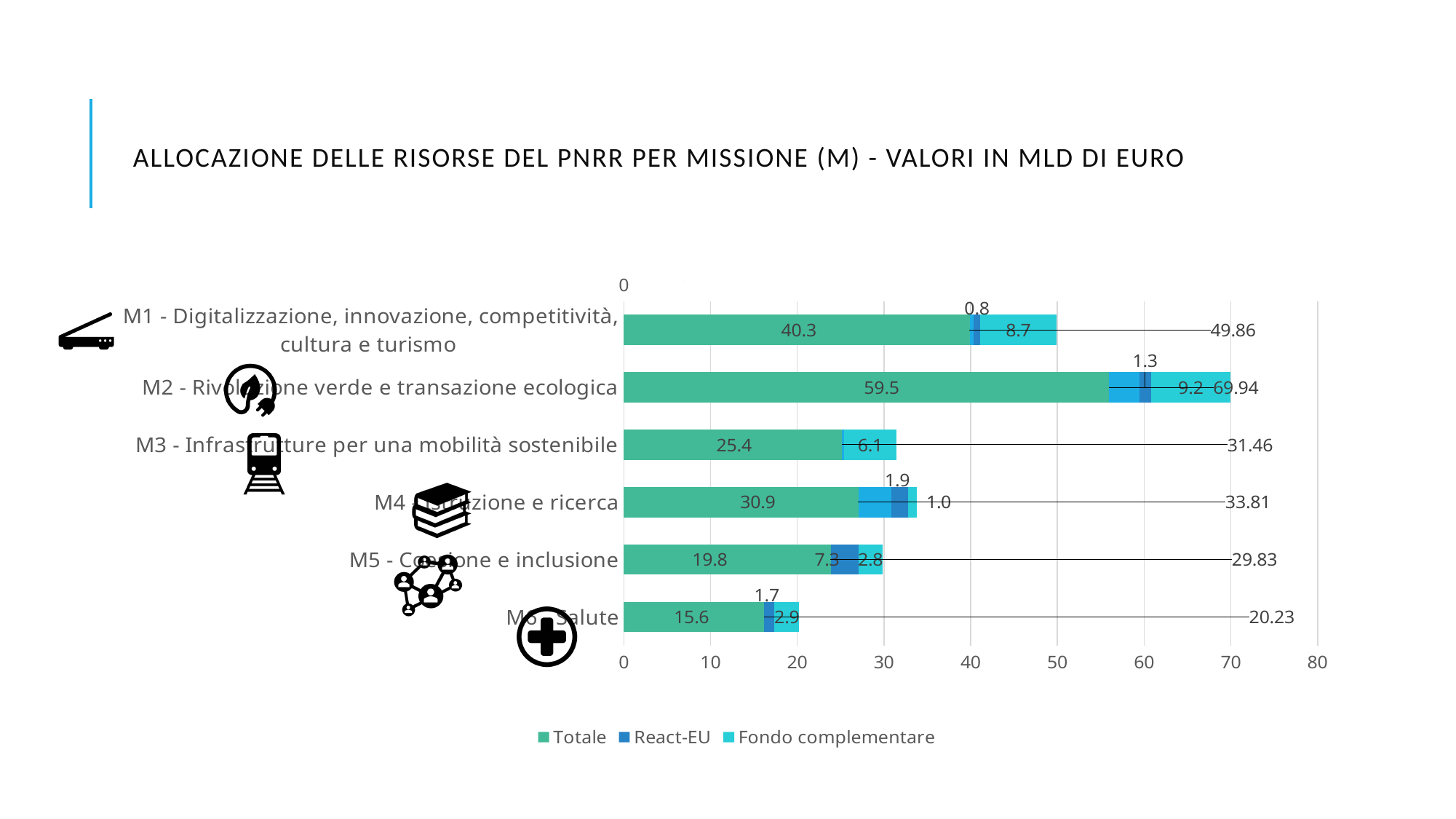
What is the Fondo complementare value for M1 - Digitalizzazione, innovazione, competitività, cultura e turismo? 8.7 What is the total of the stacked bar for M3 - Infrastrutture per una mobilità sostenibile? 31.46 Which mission has the highest overall total? M2 - Rivoluzione verde e transazione ecologica What is the React-EU value for M5 - Coesione e inclusione? 7.3 How many missions (categories) are plotted in the chart? 6 Which mission has the lowest overall total? M6 - Salute How many series does the legend list? 3 Which has the larger Fondo complementare value, M2 or M3? M2 - Rivoluzione verde e transazione ecologica What kind of chart is shown on the slide? Stacked bar chart What are the three series named in the legend? Totale, React-EU, Fondo complementare